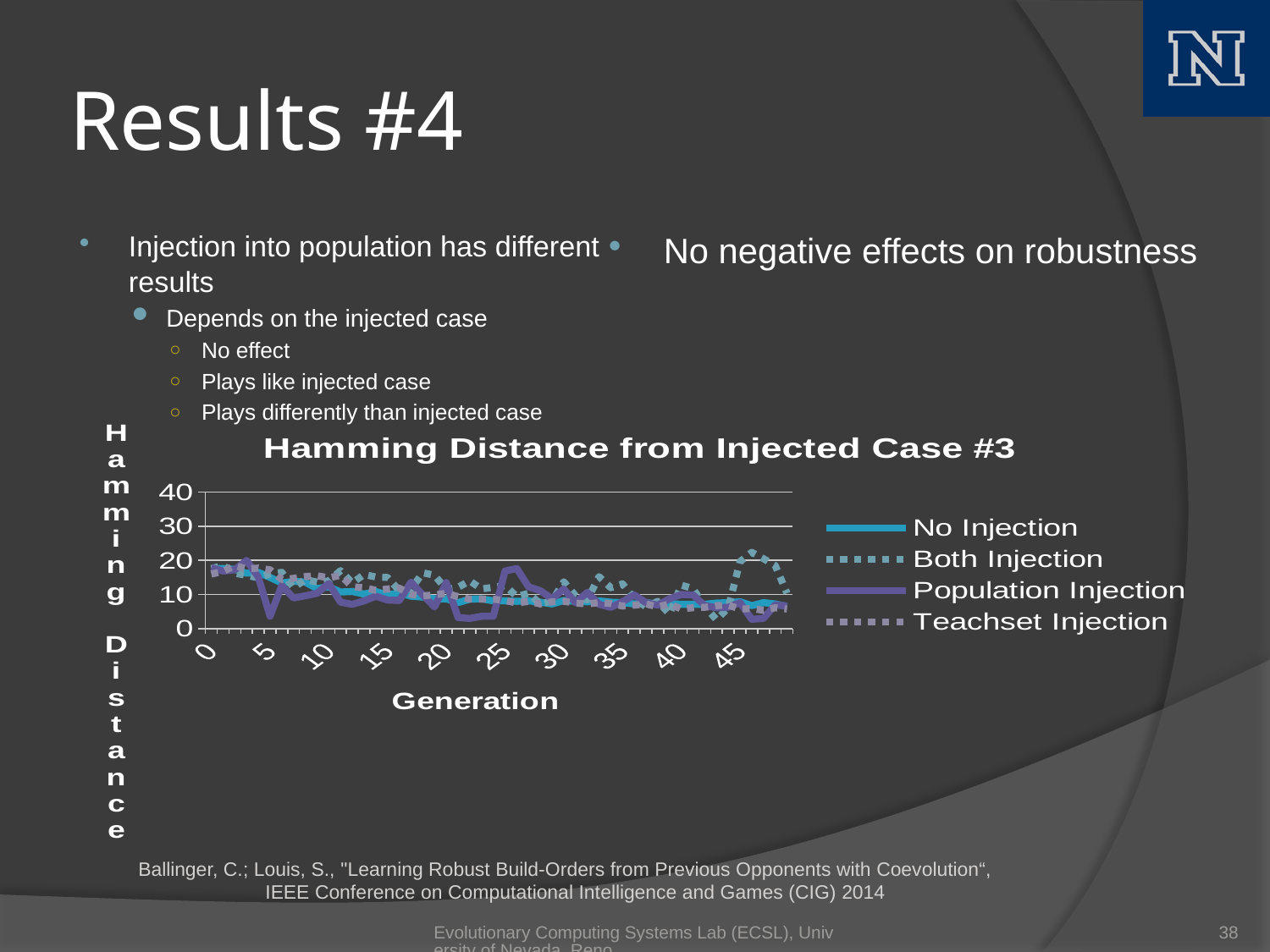
Is the value for Both Injection at generation 45 greater or less than 10? greater Is the value for Population Injection at generation 5 greater or less than 10? less Do the Hamming distance values generally rise or fall as the generation increases? fall Does any series in the chart reach a value greater than 40? No What is the label of the x axis of the chart? Generation How many series does the legend of the chart list? 4 What kind of chart is shown on the slide? line chart What is the title of the chart? Hamming Distance from Injected Case #3